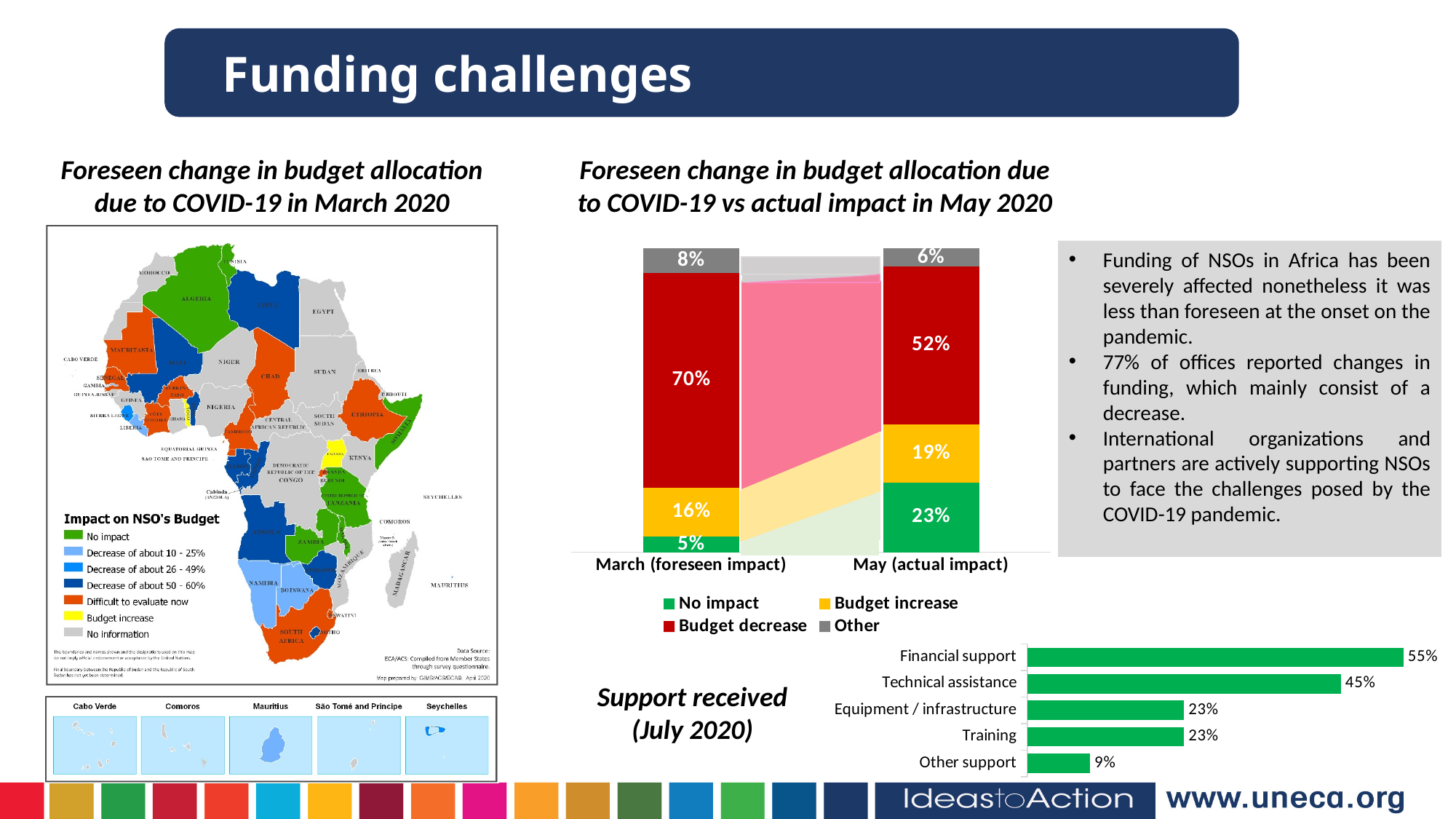
In the stacked bar chart 'Foreseen change in budget allocation due to COVID-19 vs actual impact in May 2020', what is the No impact value for May (actual impact)? 23% How many series does the legend of the stacked bar chart 'Foreseen change in budget allocation due to COVID-19 vs actual impact in May 2020' list? 4 In the 'Support received (July 2020)' chart, which category has the lowest value? Other support In the stacked bar chart 'Foreseen change in budget allocation due to COVID-19 vs actual impact in May 2020', which is larger: Budget increase in March (foreseen impact) or Budget increase in May (actual impact)? May (actual impact) In the 'Support received (July 2020)' chart, what is the value for Financial support? 55% In the 'Support received (July 2020)' chart, which category has the highest value? Financial support In the 'Support received (July 2020)' chart, what is the value for Technical assistance? 45% What kind of chart is the 'Support received (July 2020)' chart? Bar chart In the 'Support received (July 2020)' chart, what is the difference between Financial support and Technical assistance? 10% In the stacked bar chart 'Foreseen change in budget allocation due to COVID-19 vs actual impact in May 2020', what is the difference in Budget decrease between March (foreseen impact) and May (actual impact)? 18% In the stacked bar chart 'Foreseen change in budget allocation due to COVID-19 vs actual impact in May 2020', what is the Budget decrease value for March (foreseen impact)? 70% How many categories are shown in the 'Support received (July 2020)' chart? 5